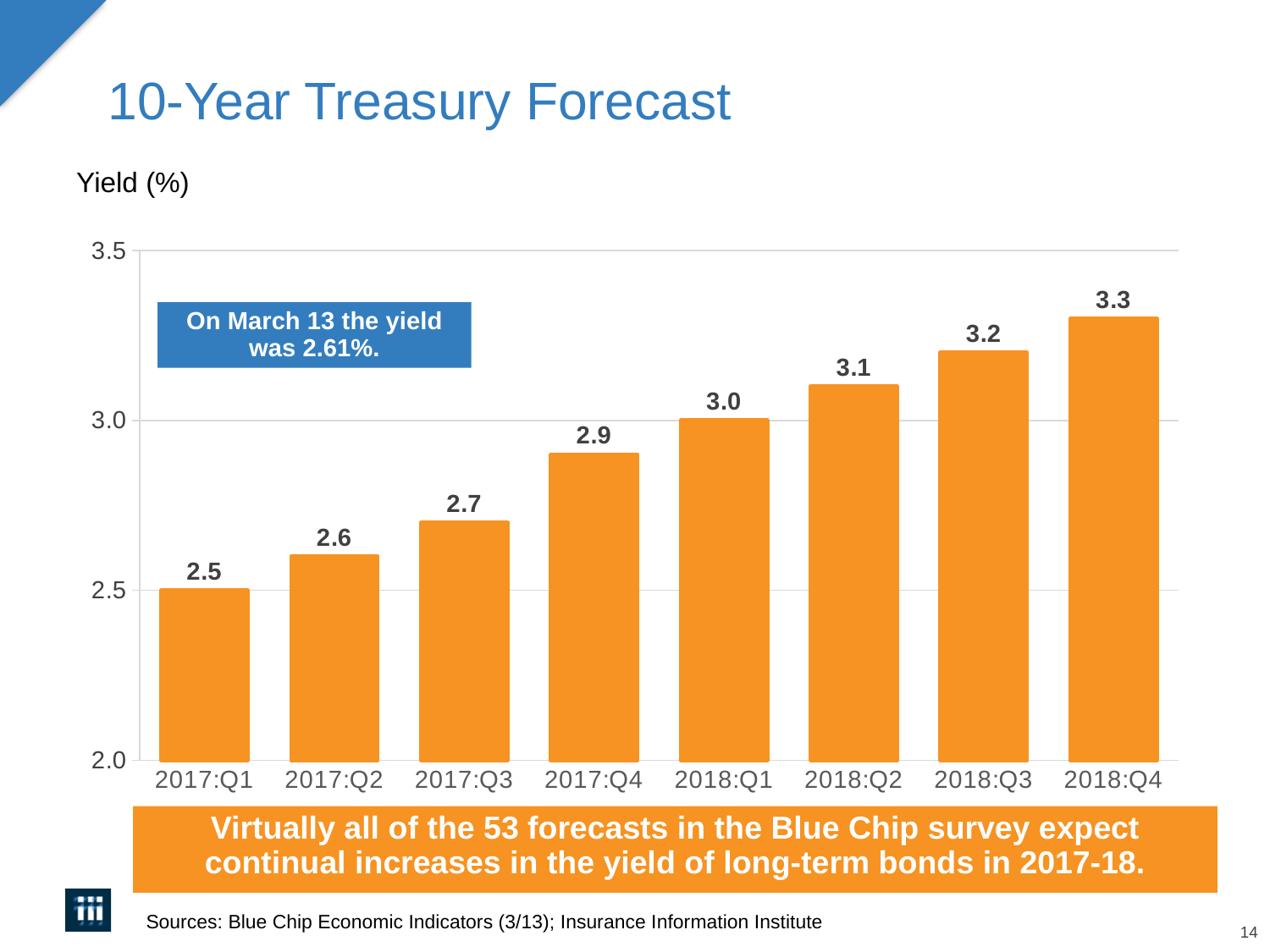
What is the difference between the forecast yield for 2018:Q4 and 2017:Q1? 0.8 Which quarter has the lowest forecast yield? 2017:Q1 Which is larger, the forecast yield for 2017:Q3 or 2018:Q1? 2018:Q1 Do the forecast yields rise or fall from 2017:Q1 to 2018:Q4? rise What kind of chart is shown on the slide? bar chart According to the callout box, what was the yield on March 13? 2.61% What is the title of the chart? 10-Year Treasury Forecast Which quarter has the highest forecast yield? 2018:Q4 How many quarters are shown on the x axis? 8 What is the forecast yield for 2018:Q2? 3.1 What is the forecast yield for 2017:Q4? 2.9 Is the forecast yield for 2017:Q2 greater or less than 3.0? less